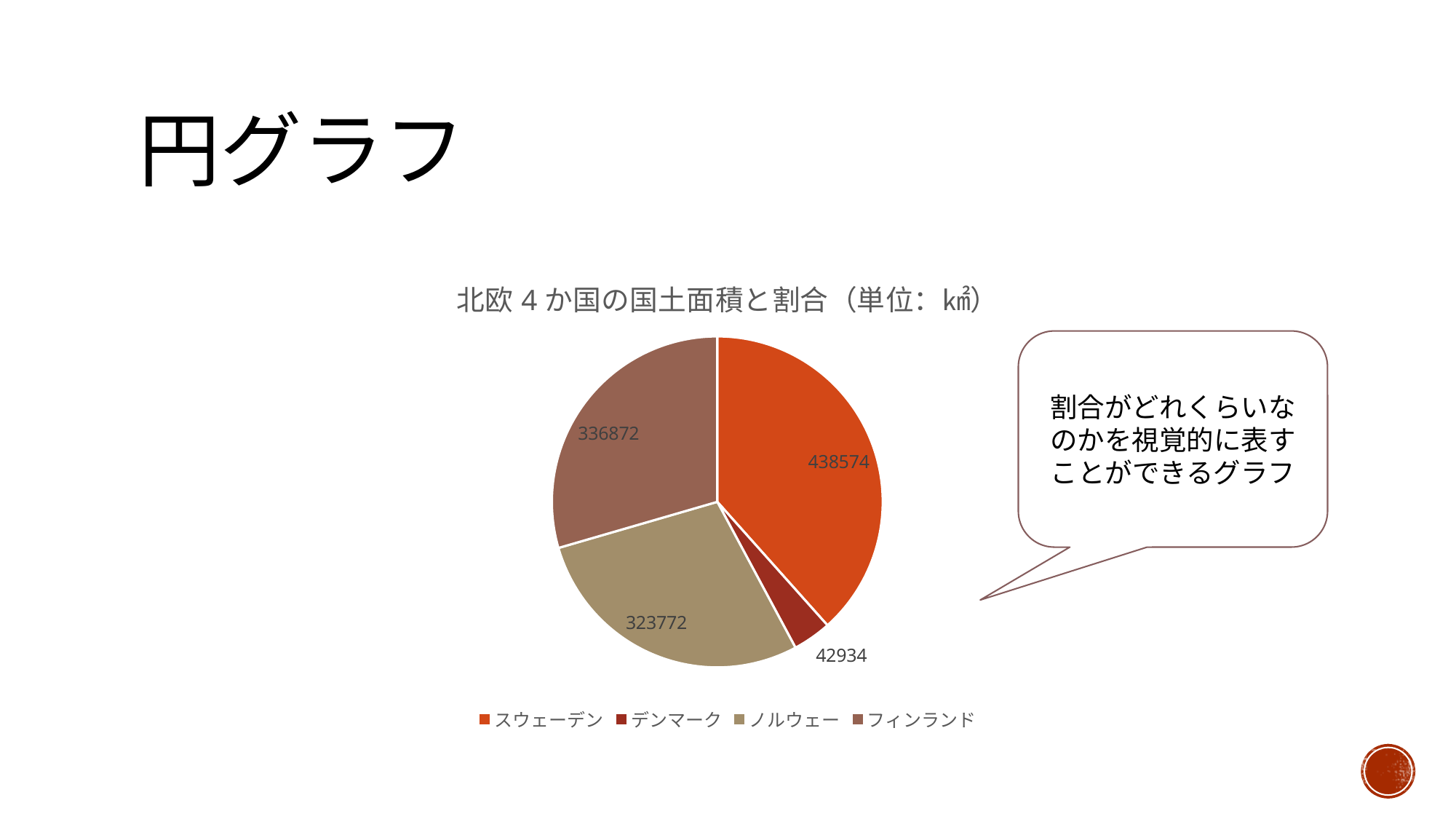
凡例に示されている項目はいくつありますか？ 4 この円グラフのタイトルは何ですか？ 北欧４か国の国土面積と割合（単位：㎢） 国土面積が最も大きい国はどこですか？ スウェーデン フィンランドとノルウェーの国土面積の差はいくつですか？ 13100 スウェーデンの国土面積の値はいくつですか？ 438574 フィンランドの国土面積の値はいくつですか？ 336872 円グラフには何か国が示されていますか？ 4 デンマークの国土面積の値はいくつですか？ 42934 国土面積が最も小さい国はどこですか？ デンマーク ノルウェーの国土面積の値はいくつですか？ 323772 フィンランドとノルウェーでは、どちらの国土面積が大きいですか？ フィンランド このグラフはどの種類のグラフですか？ 円グラフ